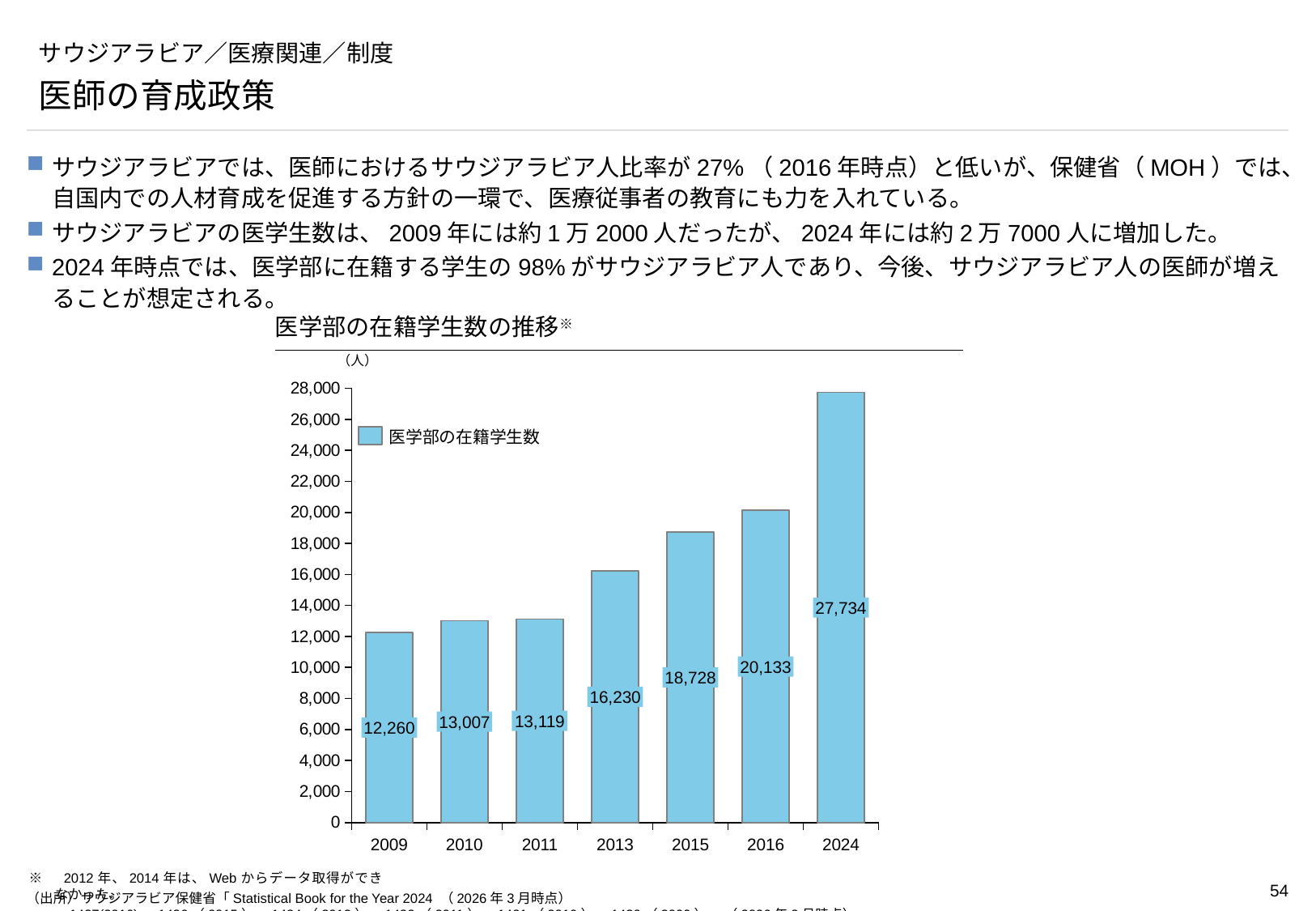
What is the value for 2013 in the chart 医学部の在籍学生数の推移? 16,230 What is the difference between the values for 2024 and 2009 in the chart 医学部の在籍学生数の推移? 15,474 What is the value for 2009 in the chart 医学部の在籍学生数の推移? 12,260 What kind of chart is 医学部の在籍学生数の推移? bar chart Do the values in the chart 医学部の在籍学生数の推移 rise or fall from 2009 to 2024? rise Which year has the highest value in the chart 医学部の在籍学生数の推移? 2024 What is the value for 2024 in the chart 医学部の在籍学生数の推移? 27,734 Which year has the lowest value in the chart 医学部の在籍学生数の推移? 2009 Which is larger in the chart 医学部の在籍学生数の推移, the value for 2013 or the value for 2015? 2015 What is the difference between the values for 2016 and 2015 in the chart 医学部の在籍学生数の推移? 1,405 How many years are shown on the x axis of the chart 医学部の在籍学生数の推移? 7 Is the value for 2016 greater or less than 18,000 in the chart 医学部の在籍学生数の推移? greater